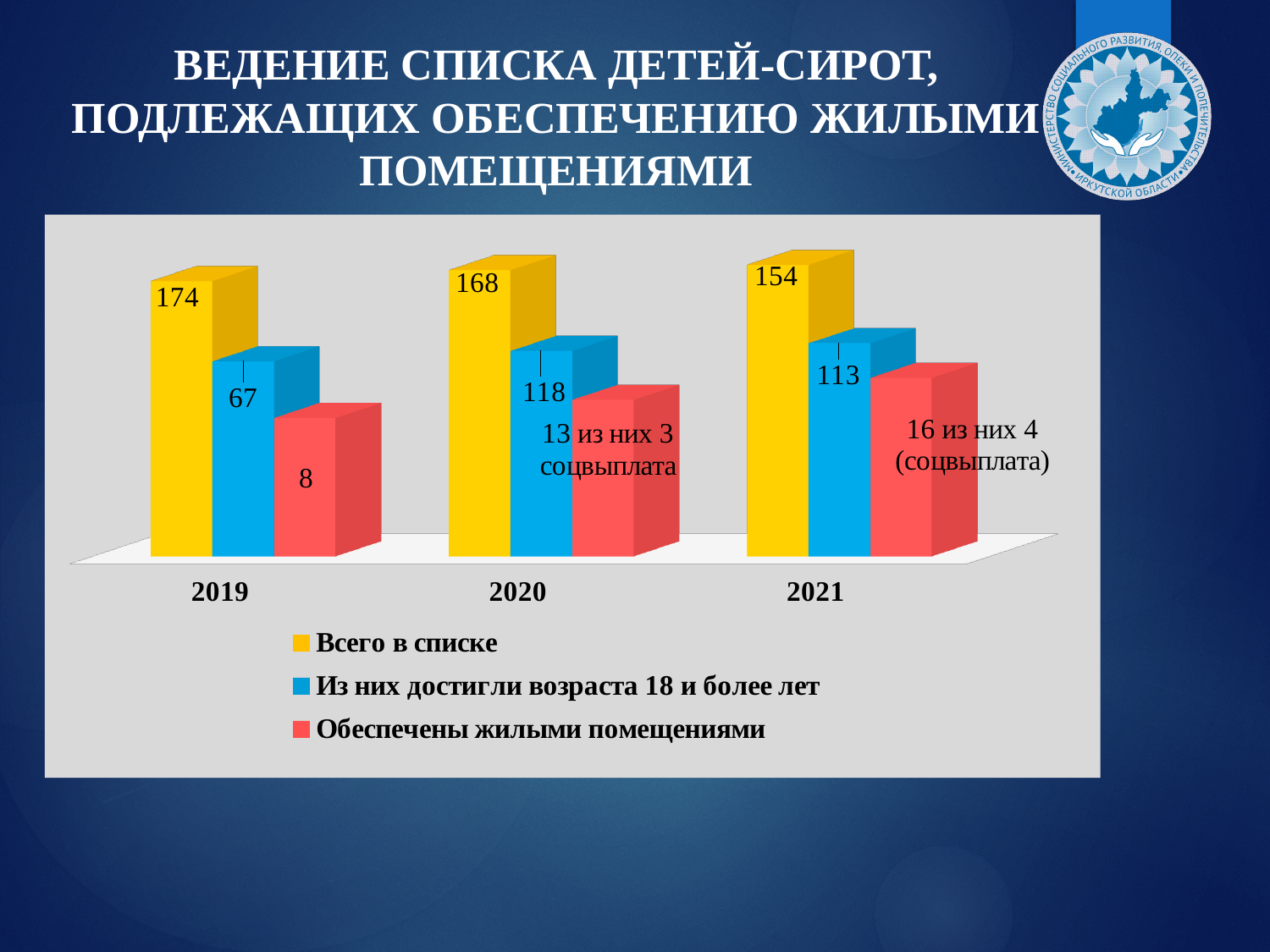
What label is printed on the "Обеспечены жилыми помещениями" bar for 2021? 16 из них 4 (соцвыплата) What is the value of "Обеспечены жилыми помещениями" for 2019? 8 What is the value of "Всего в списке" for 2019? 174 In which year is "Из них достигли возраста 18 и более лет" lowest? 2019 What is the value of "Из них достигли возраста 18 и более лет" for 2020? 118 What is the value of "Всего в списке" for 2021? 154 Which is larger: "Из них достигли возраста 18 и более лет" in 2020 or in 2021? 2020 How many years are shown on the x axis? 3 What is the difference between "Всего в списке" in 2019 and in 2020? 6 How many series does the legend list? 3